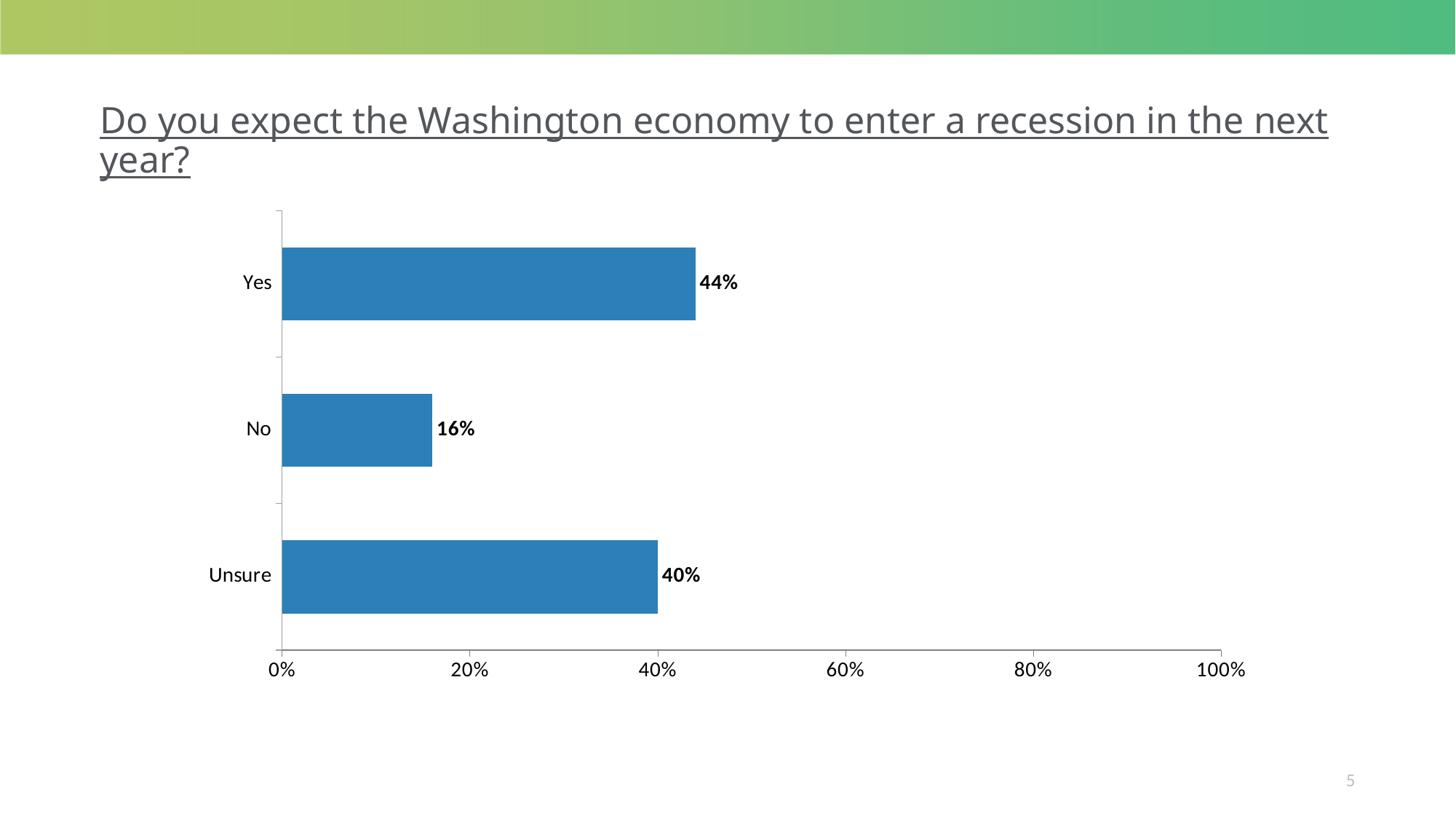
How many response categories are shown in the chart? 3 Which is larger, the value for No or the value for Unsure? Unsure What percentage of respondents answered Unsure? 40% What kind of chart is shown on the slide? bar chart Which response has the lowest percentage? No What percentage of respondents answered No? 16% What is the maximum value shown on the horizontal axis? 100% What percentage of respondents answered Yes? 44% What is the difference in percentage points between Yes and Unsure? 4% Is the value for No greater or less than 20%? less What is the difference in percentage points between Yes and No? 28% Which response has the highest percentage? Yes